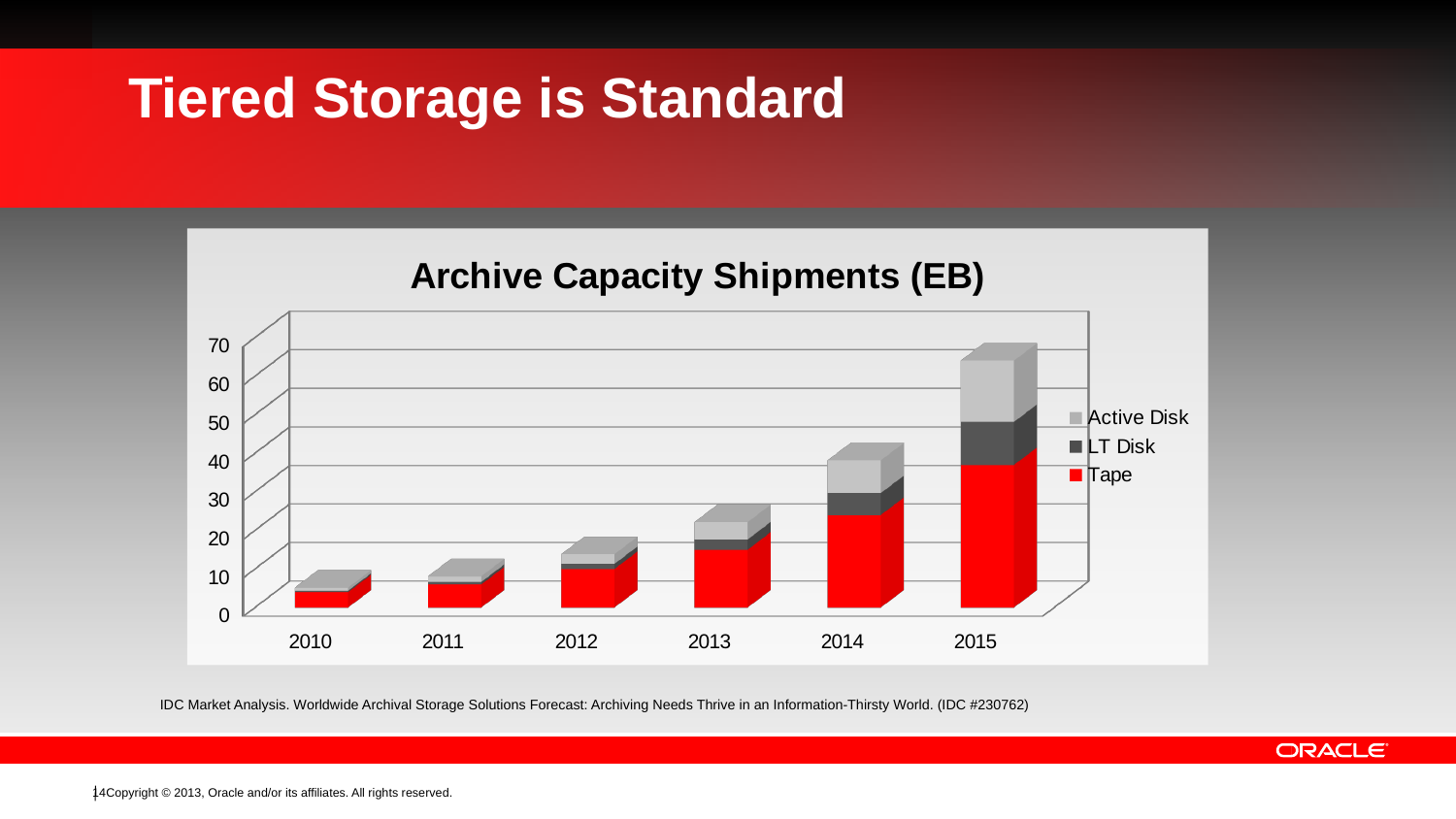
Is the total value for 2014 greater or less than 30? greater Which year has the lowest total archive capacity shipments? 2010 Is the total value for 2015 greater or less than 50? greater What type of chart is shown on the slide? Stacked bar chart How many years are shown on the x axis? 6 Which year has the highest total archive capacity shipments? 2015 Which series are listed in the legend? Active Disk, LT Disk, Tape Is the total value for 2010 greater or less than 20? less Do total archive capacity shipments rise or fall from 2010 to 2015? Rise How many series does the legend list? 3 What is the title of the chart? Archive Capacity Shipments (EB) Is the total for 2013 larger or smaller than the total for 2012? Larger